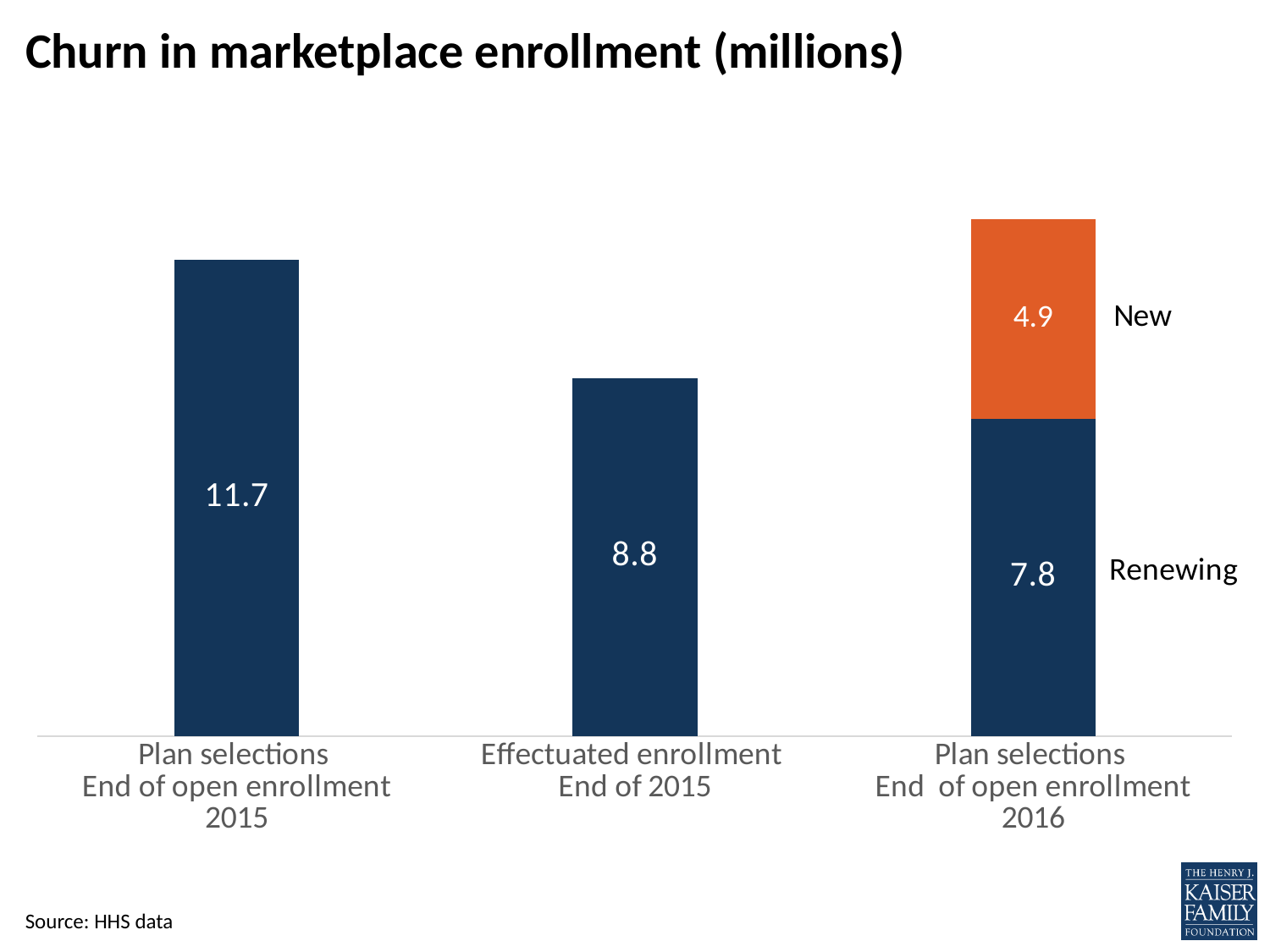
What is the difference between Plan selections at the end of open enrollment 2015 and Effectuated enrollment at the end of 2015? 2.9 Which is larger: Effectuated enrollment at the end of 2015 or the Renewing portion of 2016 plan selections? Effectuated enrollment End of 2015 How many categories are shown on the x axis? 3 What is the value for Effectuated enrollment at the end of 2015? 8.8 What is the Renewing value for Plan selections at the end of open enrollment 2016? 7.8 What kind of chart is this? Bar chart What is the difference between the Renewing and New values in the 2016 plan selections bar? 2.9 What is the total of the stacked bar for Plan selections at the end of open enrollment 2016? 12.7 What colour is the New segment of the 2016 bar? Orange What is the New value for Plan selections at the end of open enrollment 2016? 4.9 What is the value for Plan selections at the end of open enrollment 2015? 11.7 What is the title of the chart? Churn in marketplace enrollment (millions)